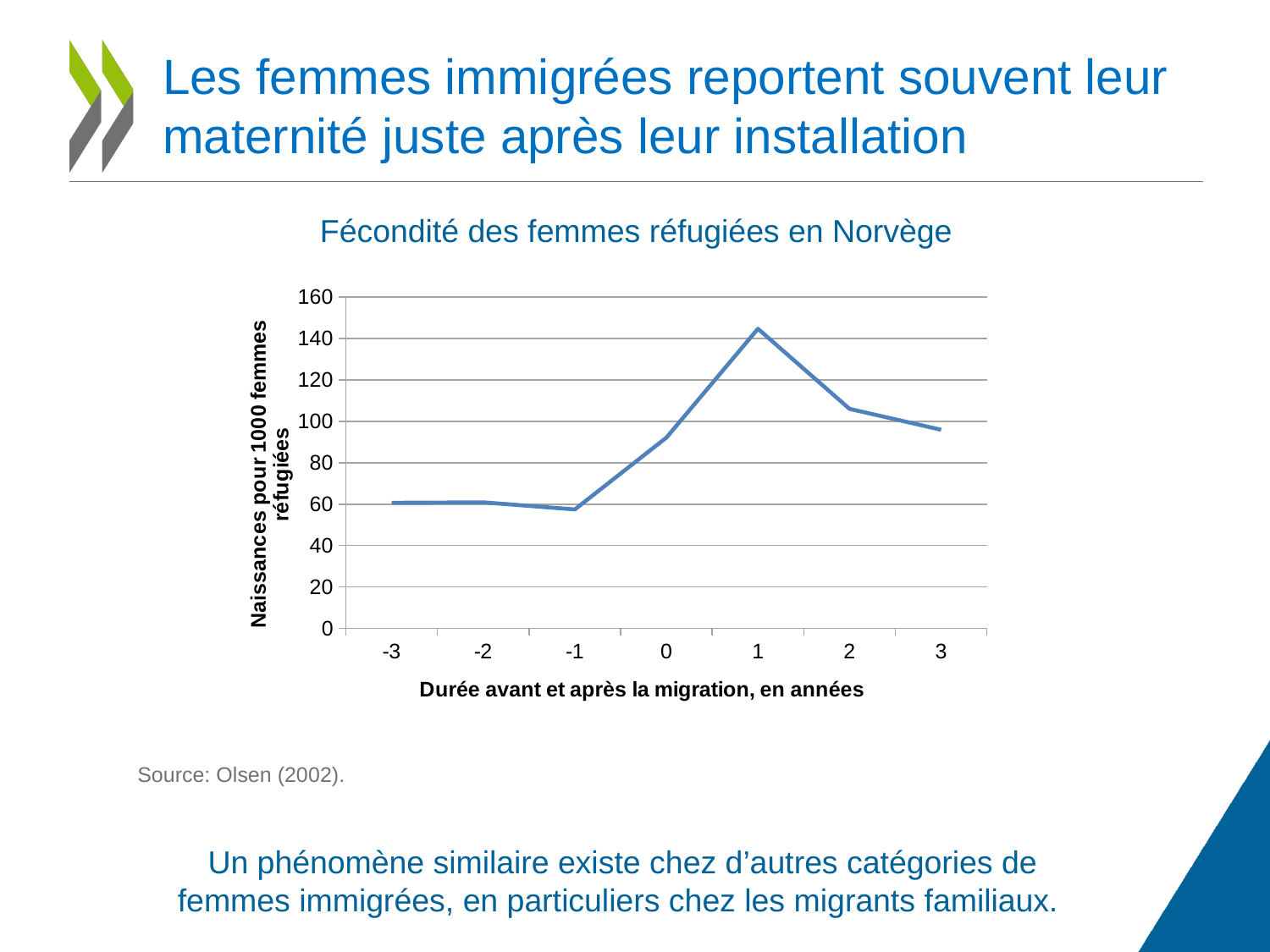
Which is larger, the value at year 2 or the value at year 1? year 1 What is the label of the x axis? Durée avant et après la migration, en années Do the values rise or fall between year 1 and year 3? fall Is the value at year 3 greater or less than 120? less How many data points are plotted along the x axis? 7 Is the value at year -3 greater or less than 80? less At which duration (in years before/after migration) is the number of births per 1000 refugee women highest? 1 Which is larger, the value at year 0 or the value at year -1? year 0 Is the value at year 1 greater or less than 120? greater What kind of chart is shown on the slide? line chart What is the title of the chart? Fécondité des femmes réfugiées en Norvège